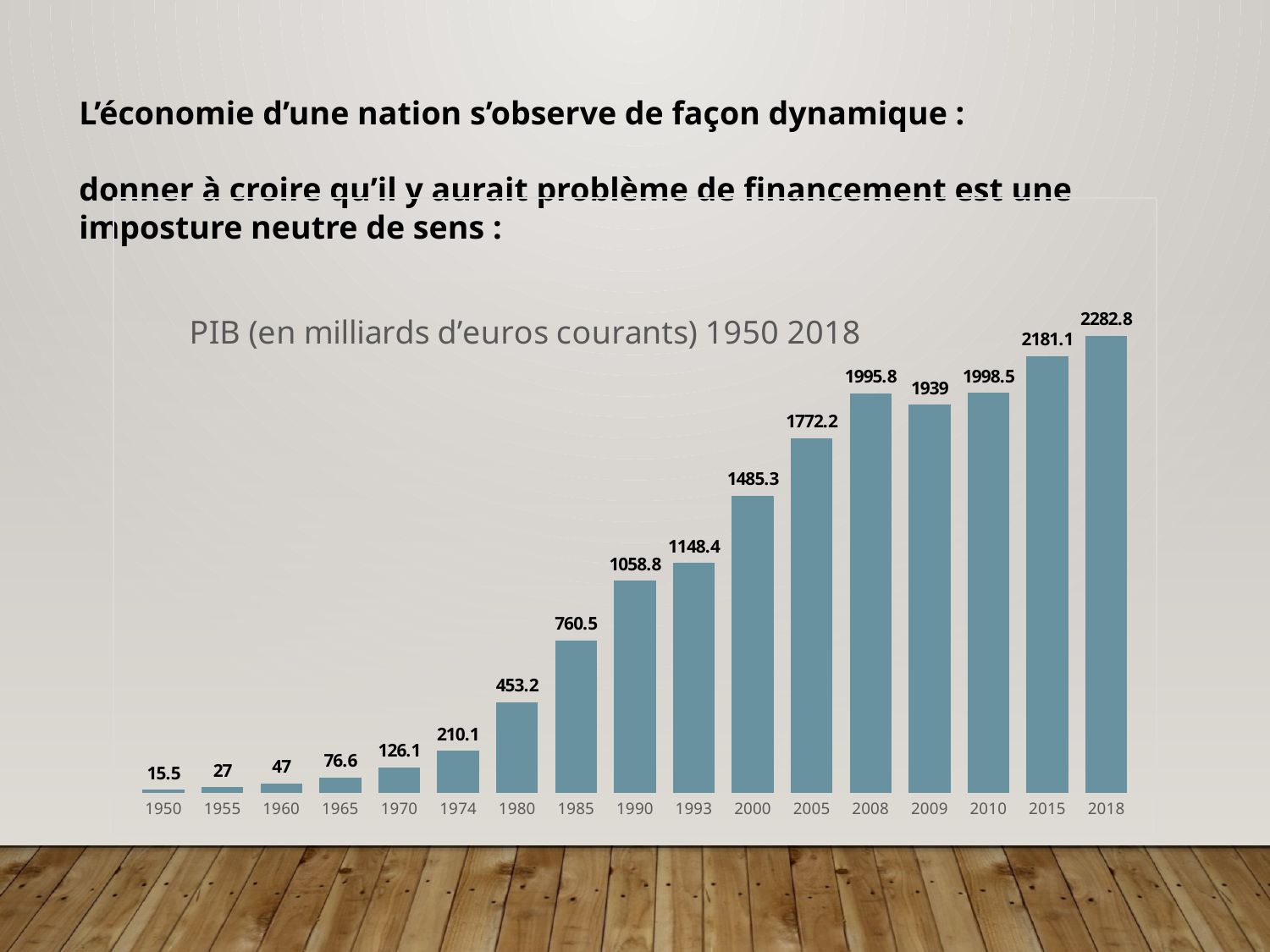
Which year has the highest value? 2018 Do the values generally rise or fall from 1950 to 2018? Rise What is the value for 2009? 1939 What is the value for 1950? 15.5 What is the difference between the values for 2018 and 2015? 101.7 What is the title of the chart? PIB (en milliards d’euros courants) 1950 2018 Which is larger, the value for 2008 or the value for 2010? 2010 What is the difference between the values for 2008 and 2009? 56.8 What kind of chart is this? Bar chart How many years are shown on the x axis? 17 Which year has the lowest value? 1950 What is the value for 2000? 1485.3